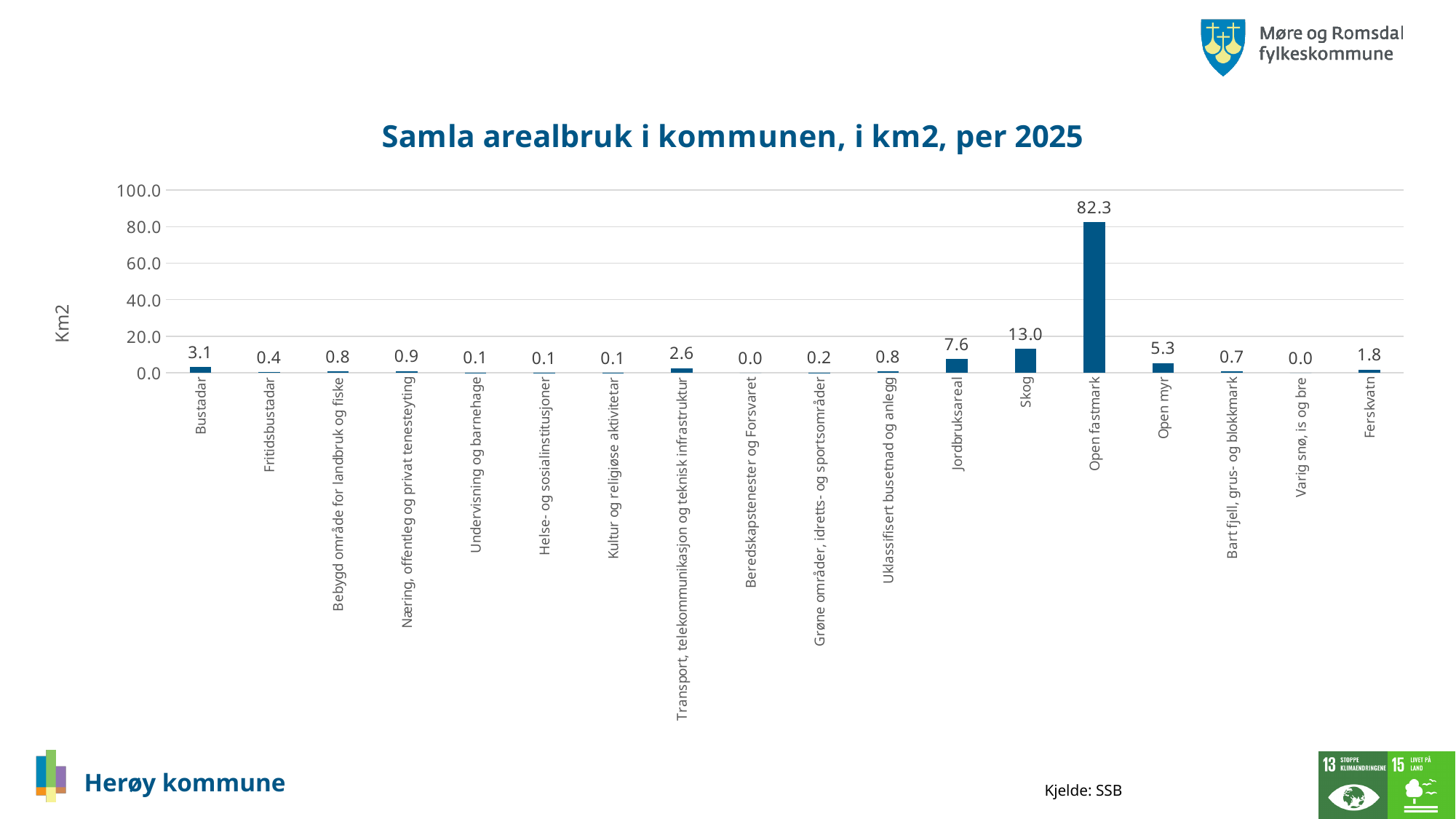
What is the value for Bustadar? 3.1 How many categories are shown on the x axis? 18 What is the difference between the values for Open fastmark and Skog? 69.3 What is the value for Skog? 13.0 Which is larger, the value for Open myr or the value for Bustadar? Open myr What type of chart is shown on the slide? Bar chart What is the difference between the values for Skog and Jordbruksareal? 5.4 What is the value for Ferskvatn? 1.8 What is the value for Open fastmark? 82.3 Is the value for Open fastmark greater or less than 80.0? greater What is the value for Jordbruksareal? 7.6 Which category has the highest value? Open fastmark